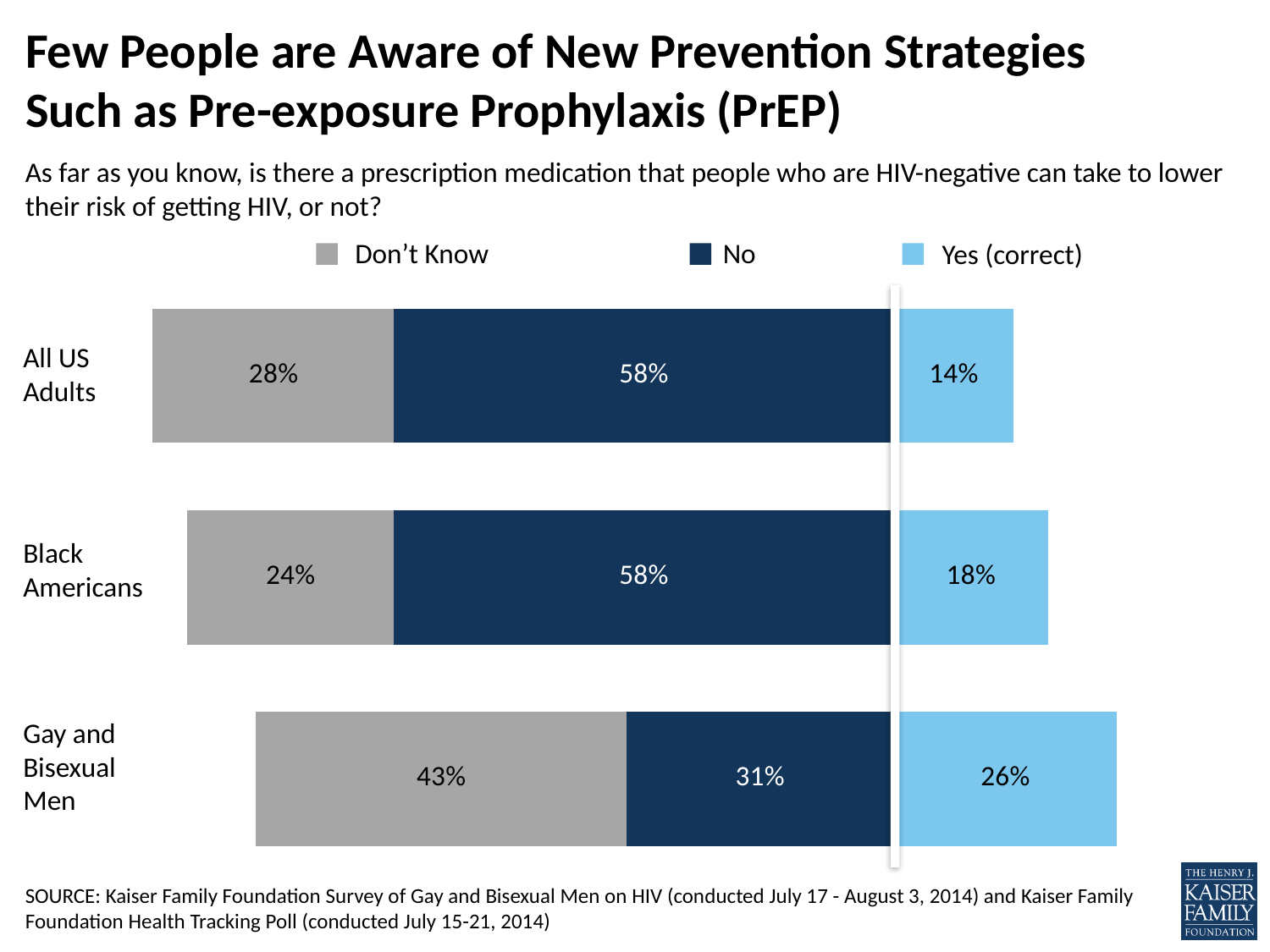
Which is larger: the "No" percentage for All US Adults or for Gay and Bisexual Men? All US Adults Which response category is shown in light blue in the legend? Yes (correct) Which group has the highest "Yes (correct)" percentage? Gay and Bisexual Men Which group has the lowest "Don't Know" percentage? Black Americans How many series does the legend list? 3 What percentage of Black Americans answered "No"? 58% What is the difference between the "Yes (correct)" percentages for Gay and Bisexual Men and All US Adults? 12 percentage points What kind of chart is shown on the slide? Stacked bar chart How many groups are shown in the chart? 3 What percentage of Gay and Bisexual Men answered "Don't Know"? 43% What is the total of the three segments in the Black Americans bar? 100% What percentage of All US Adults answered "Yes (correct)"? 14%